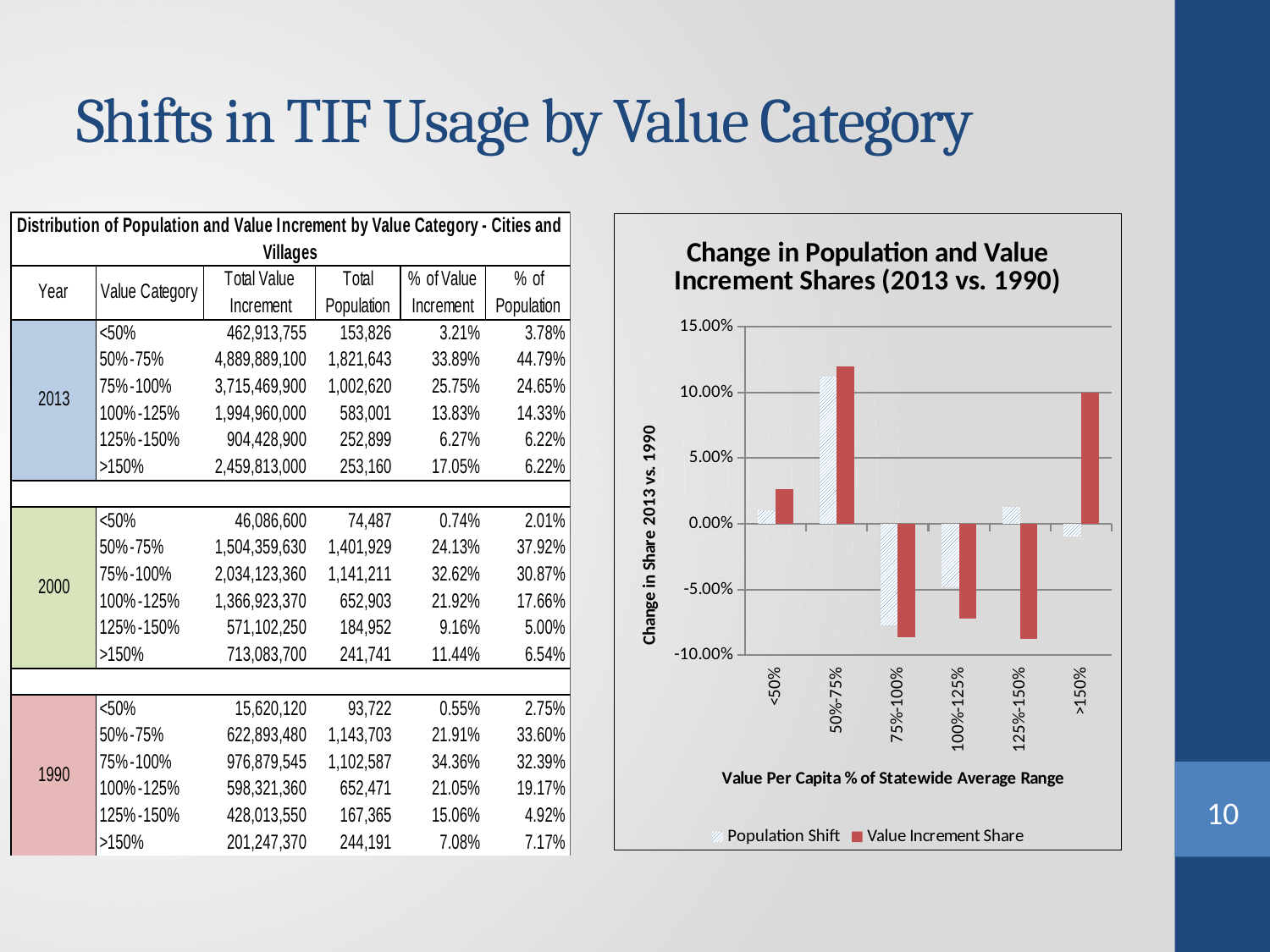
For the 100%-125% category, which is larger: Population Shift or Value Increment Share? Population Shift For the >150% category, which is larger: Population Shift or Value Increment Share? Value Increment Share What kind of chart is shown on the slide? bar chart What is the title of the chart on the slide? Change in Population and Value Increment Shares (2013 vs. 1990) How many series does the chart legend list? 2 Is the Value Increment Share for 75%-100% greater or less than -5.00%? less Which value category has the highest Value Increment Share in the chart? 50%-75% Which value category has the lowest Population Shift in the chart? 75%-100% Which value category has the highest Population Shift in the chart? 50%-75% Is the Population Shift for 75%-100% greater or less than -5.00%? less How many value categories are shown on the x axis of the chart? 6 Is the Value Increment Share for 50%-75% greater or less than 10.00%? greater